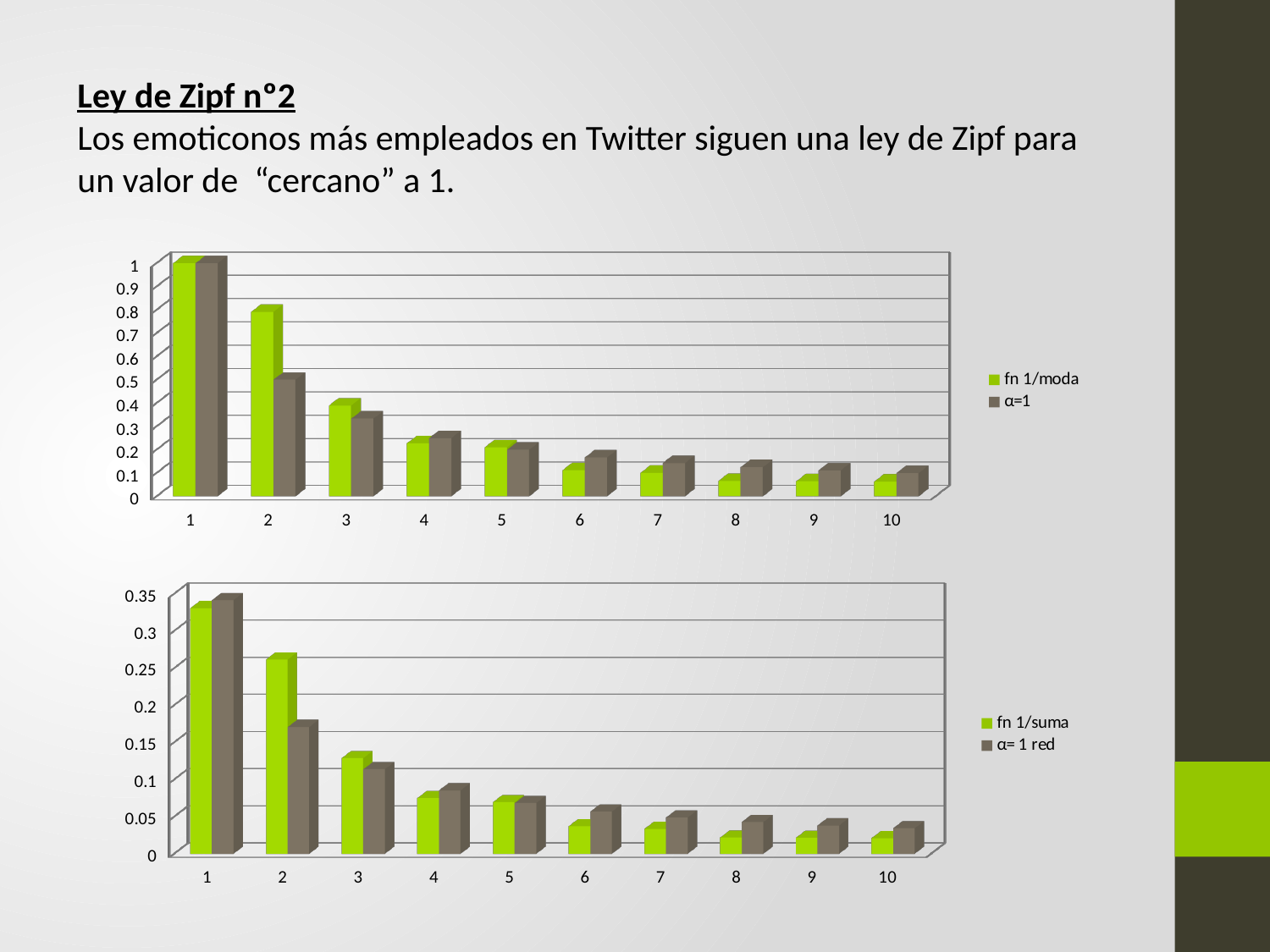
In the top chart, how many categories are shown on the x axis? 10 In the top chart, for category 2, which series has the larger value, fn 1/moda or α=1? fn 1/moda In the top chart, which category has the highest value for fn 1/moda? 1 In the bottom chart, is the fn 1/suma value for category 2 greater or less than 0.2? greater In the top chart, for category 6, which series has the larger value, fn 1/moda or α=1? α=1 In the bottom chart, what are the two legend entries? fn 1/suma and α= 1 red In the top chart, how many series does the legend list? 2 In the top chart, is the fn 1/moda value for category 2 greater or less than 0.7? greater In the top chart, what are the two legend entries? fn 1/moda and α=1 What kind of chart is the top chart on the slide? bar chart In the top chart, do the fn 1/moda values rise or fall as the category number increases from 1 to 10? fall In the bottom chart, do the α= 1 red values rise or fall as the category number increases from 1 to 10? fall